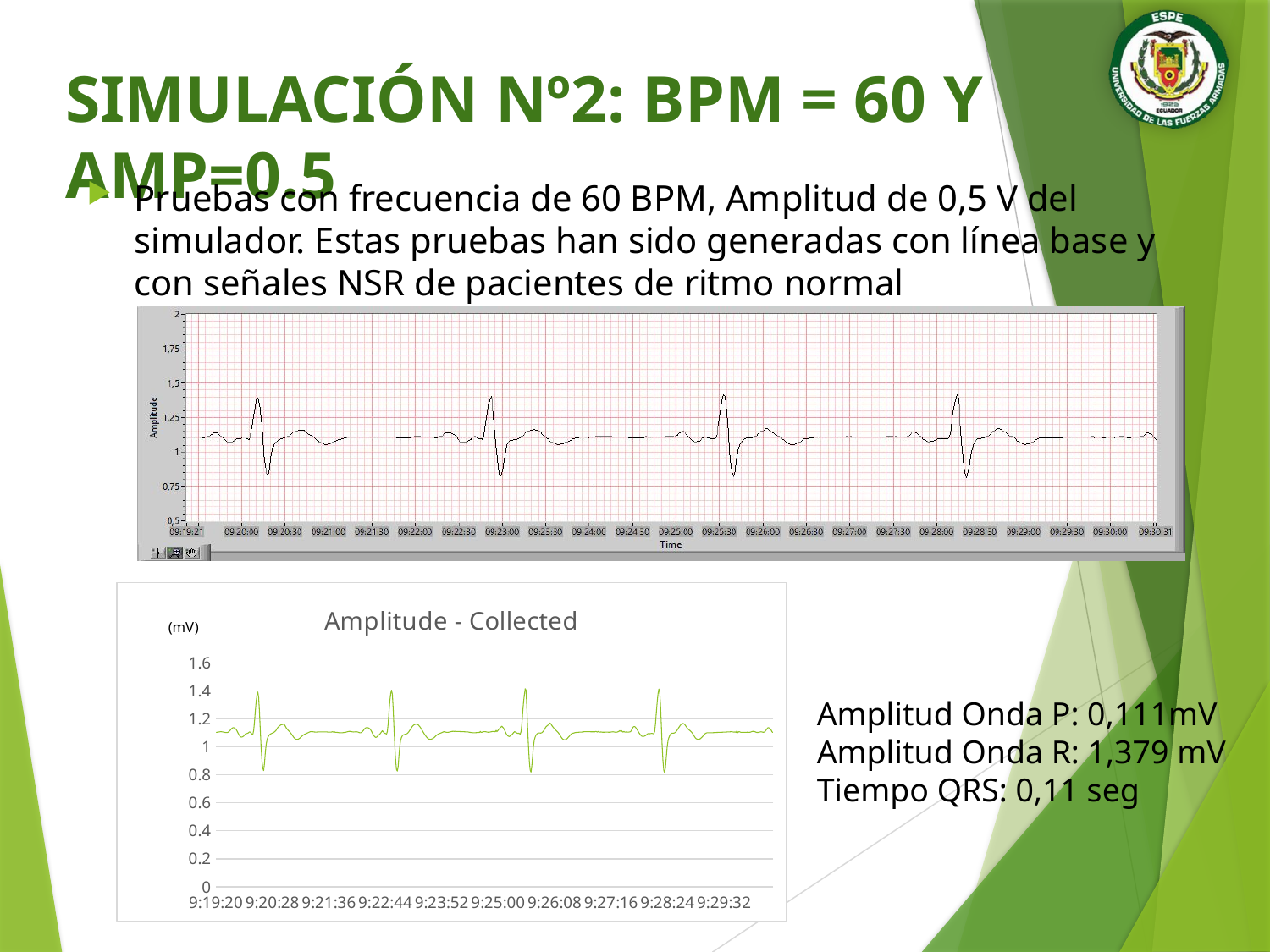
In the bottom chart "Amplitude - Collected", how many large R-wave peaks are plotted? 4 In the bottom chart "Amplitude - Collected", is the value at the R-wave peaks greater or less than 1.2? greater In the top chart, is the value at the R-wave peaks greater or less than 1,5? less What kind of chart is the bottom chart titled "Amplitude - Collected"? line chart In the top chart, is the value at the R-wave peaks greater or less than 1,25? greater In the bottom chart "Amplitude - Collected", what is the highest tick value shown on the y axis? 1.6 In the top chart, how many QRS complexes (large spikes) are plotted? 4 In the bottom chart "Amplitude - Collected", what unit is shown for the y axis? mV What kind of chart is the top chart? line chart